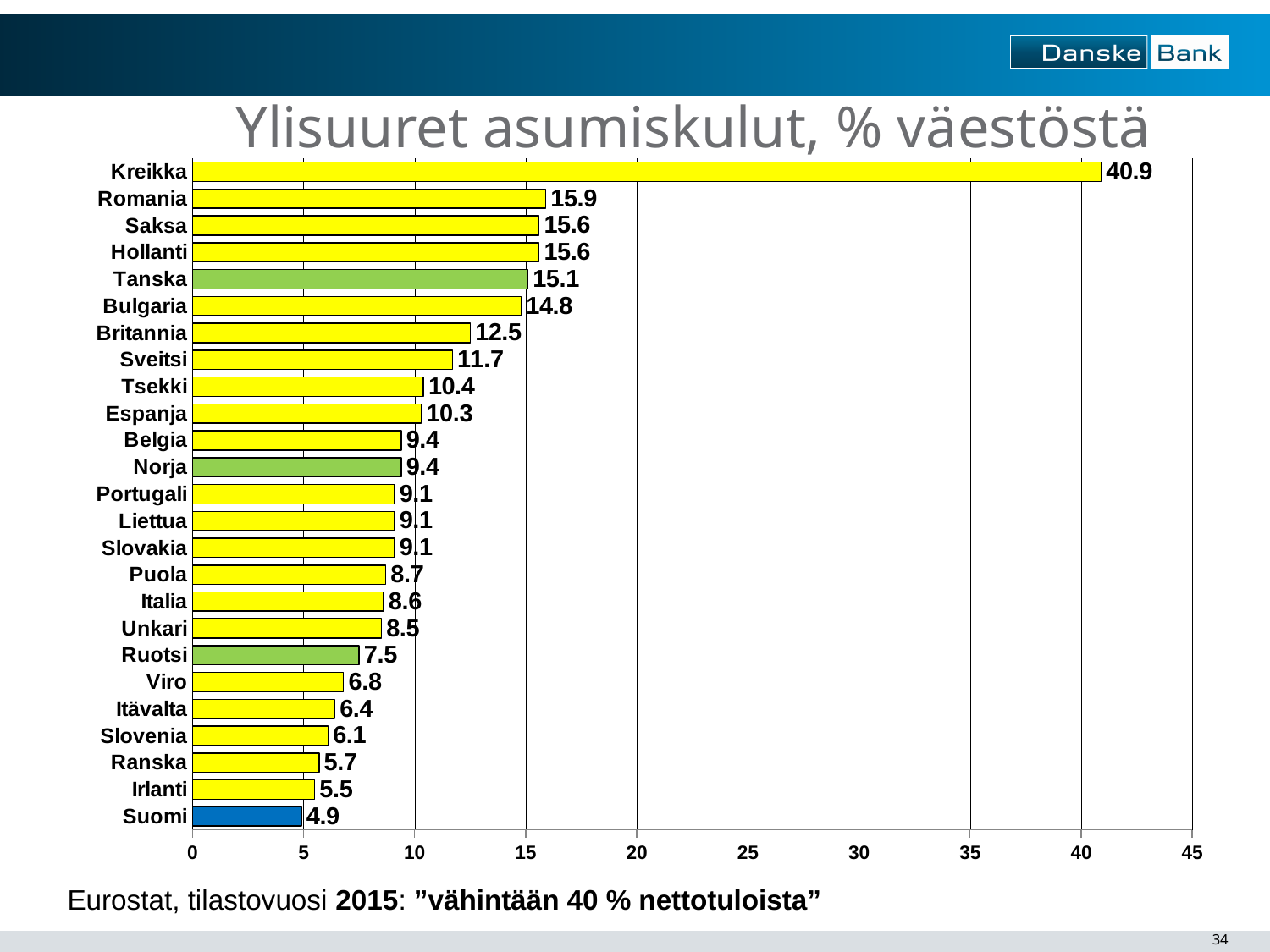
What kind of chart is shown on the slide? Bar chart What is the difference between the values for Tanska and Suomi? 10.2 Which country has the highest value? Kreikka What is the value for Kreikka? 40.9 What is the title of the chart? Ylisuuret asumiskulut, % väestöstä What is the difference between the values for Kreikka and Romania? 25.0 How many countries are shown in the chart? 25 Which country has the lowest value? Suomi What is the value for Suomi? 4.9 Which has a larger value, Britannia or Sveitsi? Britannia What is the value for Ruotsi? 7.5 What is the value for Tanska? 15.1